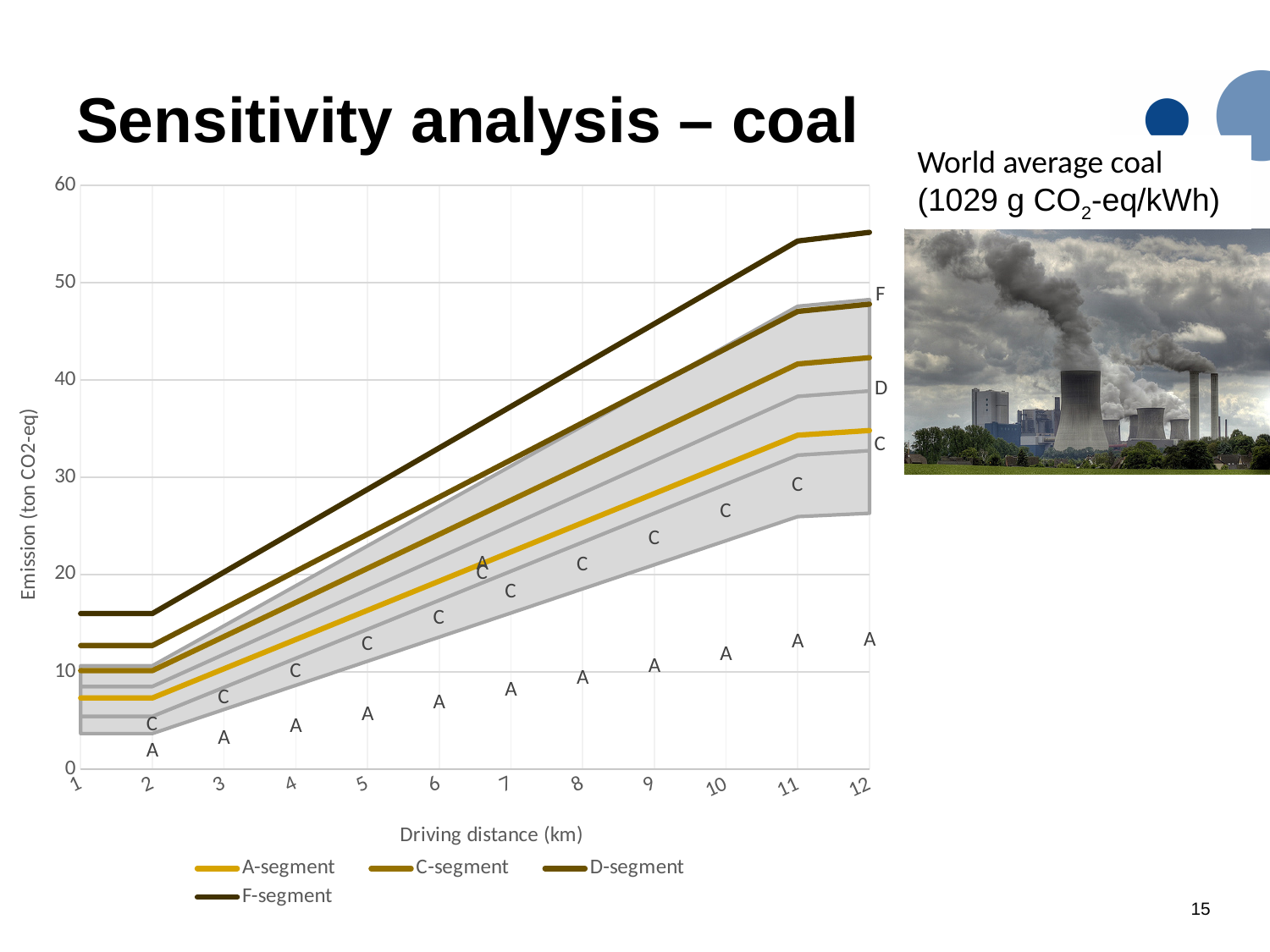
How many driving distance values are marked along the x axis? 12 What kind of chart is shown on the slide? combination area and line chart Which segment has the lowest emission at a driving distance of 12 km? A-segment How many series does the legend list? 4 Which segment has the highest emission at a driving distance of 12 km? F-segment At 12 km, which is larger: the emission of the F-segment or the A-segment? F-segment Is the D-segment emission at 12 km greater or less than 50? less Is the F-segment emission at 12 km greater or less than 50? greater What is the title of the y axis? Emission (ton CO2-eq) Is the C-segment emission at 12 km greater or less than 40? greater Do the emission values rise or fall as driving distance increases from 2 km to 11 km? rise